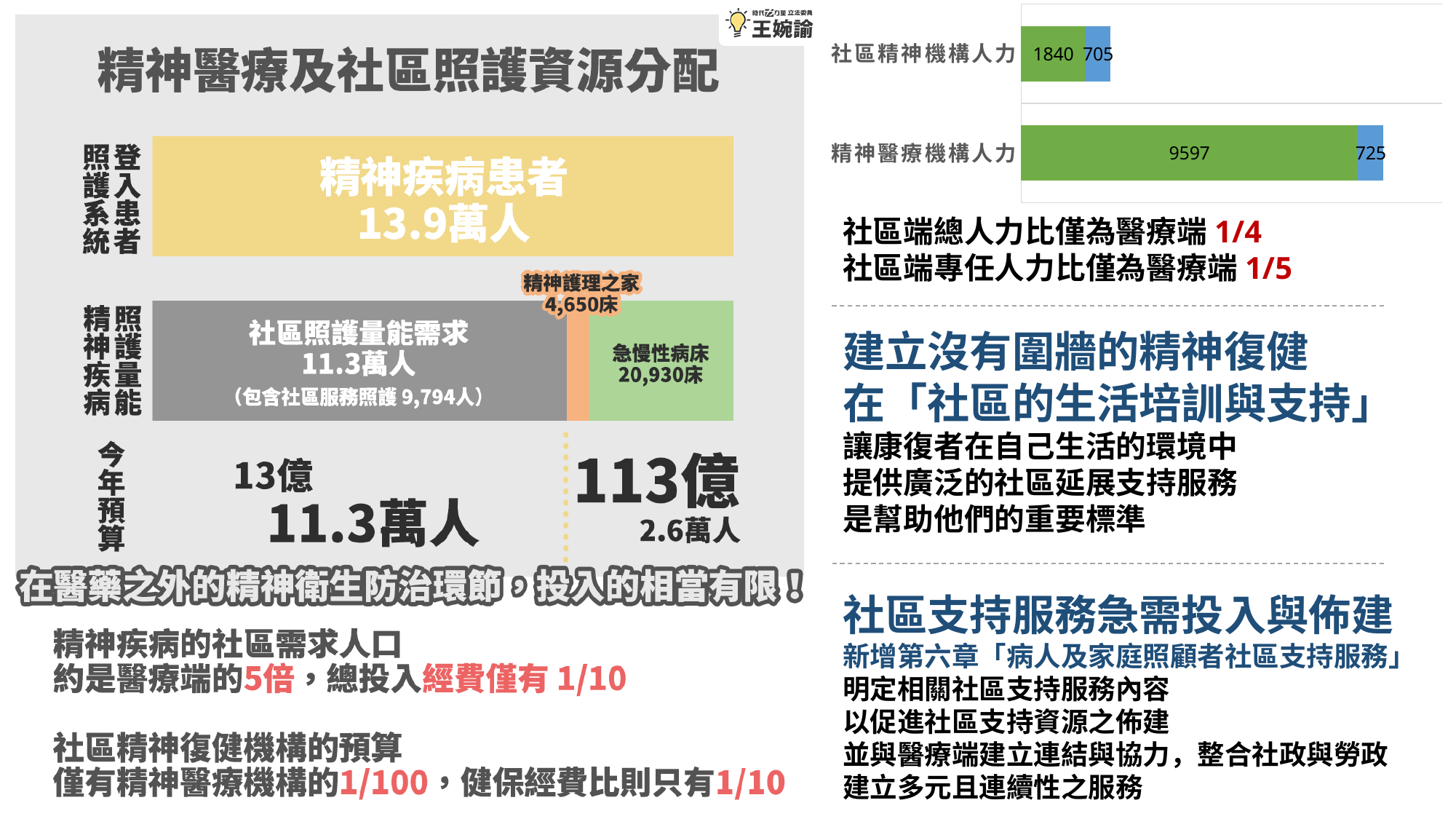
In the bar chart at the top right, what is the value of the blue segment for 社區精神機構人力? 705 In the bar chart at the top right, what is the difference between the blue segment values of 精神醫療機構人力 and 社區精神機構人力? 20 In the bar chart at the top right, what is the value of the blue segment for 精神醫療機構人力? 725 What kind of chart is shown at the top right of the slide? Stacked bar chart In the bar chart at the top right, what is the total of the stacked bar for 社區精神機構人力? 2545 In the bar chart at the top right, what is the value of the green segment for 社區精神機構人力? 1840 In the bar chart at the top right, which category has the larger green segment, 社區精神機構人力 or 精神醫療機構人力? 精神醫療機構人力 In the bar chart at the top right, what is the difference between the green segment values of 精神醫療機構人力 and 社區精神機構人力? 7757 In the bar chart at the top right, what is the value of the green segment for 精神醫療機構人力? 9597 How many categories are shown in the bar chart at the top right? 2 In the bar chart at the top right, which category has the longer bar overall? 精神醫療機構人力 In the bar chart at the top right, what is the total of the stacked bar for 精神醫療機構人力? 10322